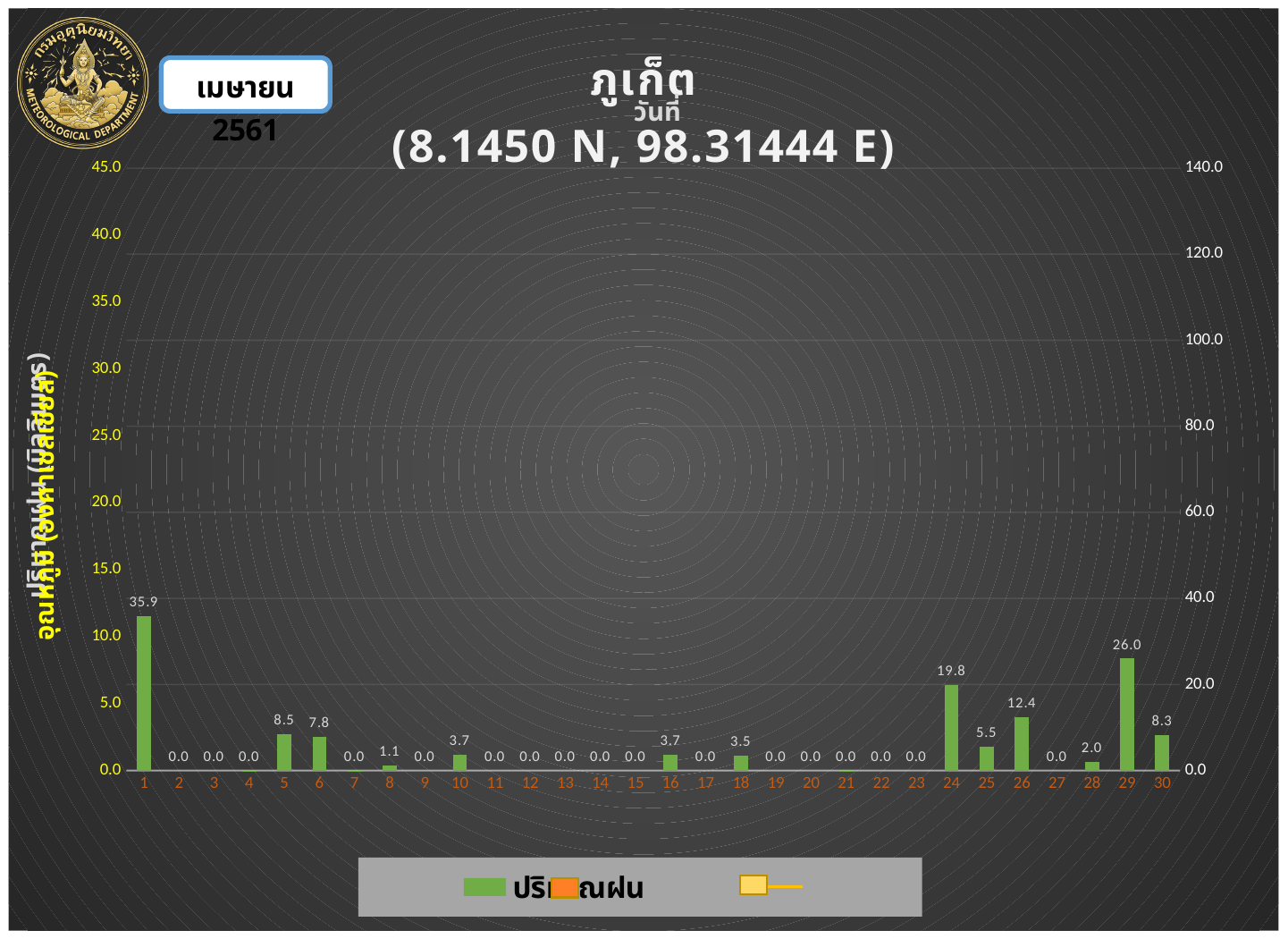
What kind of chart is shown on the slide? bar chart Which day has the highest rainfall value? 1 Which has a larger rainfall value, day 5 or day 6? day 5 What is the rainfall value shown for day 24? 19.8 What is the difference between the rainfall values for day 24 and day 26? 7.4 What is the rainfall value shown for day 1? 35.9 What is the difference between the rainfall values for day 1 and day 29? 9.9 What coordinates are given in the chart title? 8.1450 N, 98.31444 E Which has a larger rainfall value, day 25 or day 30? day 30 What is the rainfall value shown for day 29? 26.0 What is the rainfall value shown for day 26? 12.4 How many days are shown on the x axis? 30